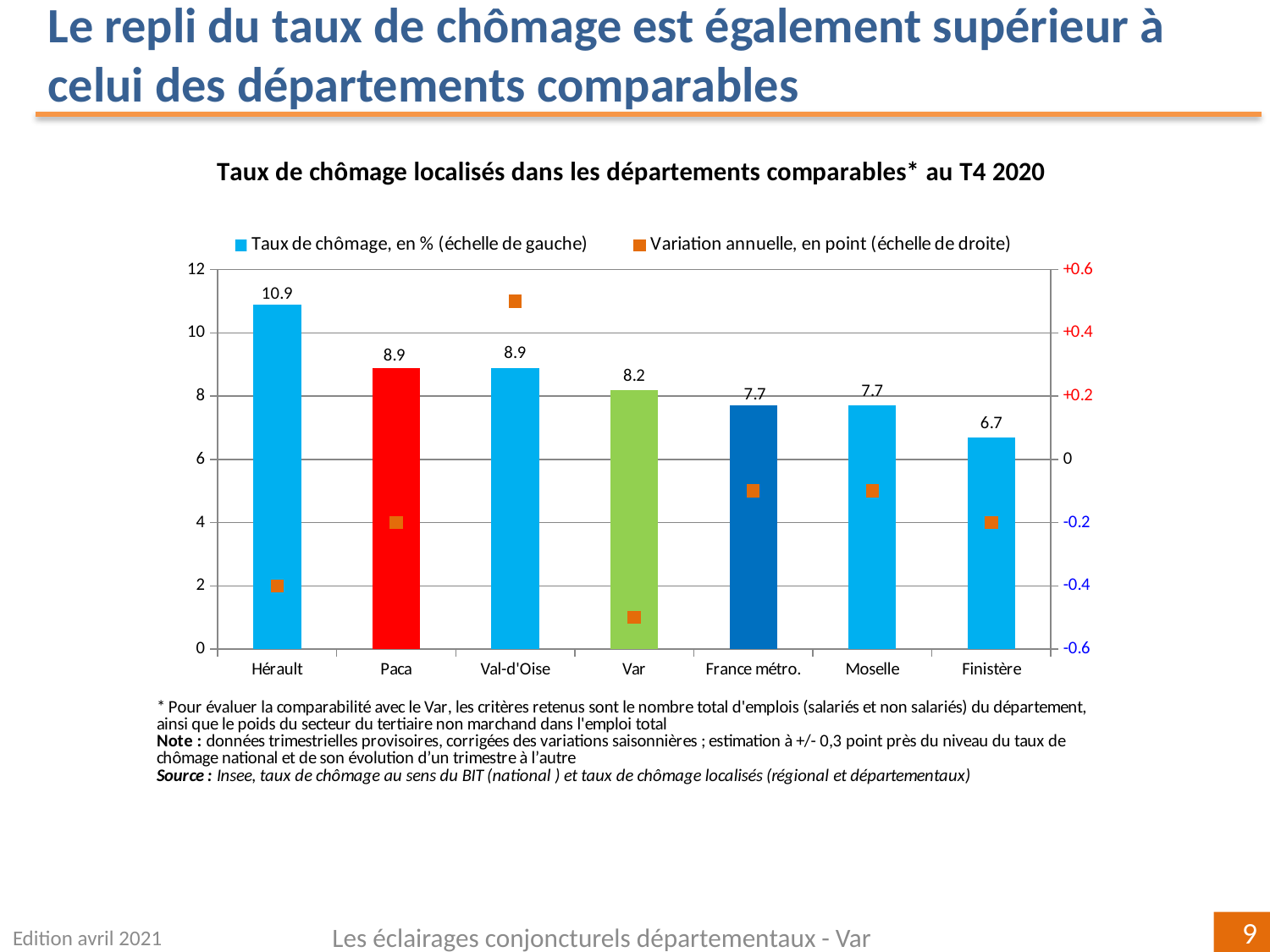
What colour is the bar for Paca? Red Which has a higher unemployment rate, Var or Moselle? Var What is the difference between the unemployment rate of Hérault and that of Var? 2.7 Is the annual variation (Variation annuelle) for Var greater or less than -0.4? less Which category has the lowest unemployment rate in the chart? Finistère Is the annual variation for Val-d'Oise greater or less than +0.4? greater How many series does the chart legend list? 2 How many categories are shown on the x axis of the chart? 7 What is the unemployment rate (taux de chômage) shown for Hérault? 10.9 Which department has the highest unemployment rate in the chart? Hérault What is the unemployment rate shown for Finistère? 6.7 What is the unemployment rate shown for Var? 8.2